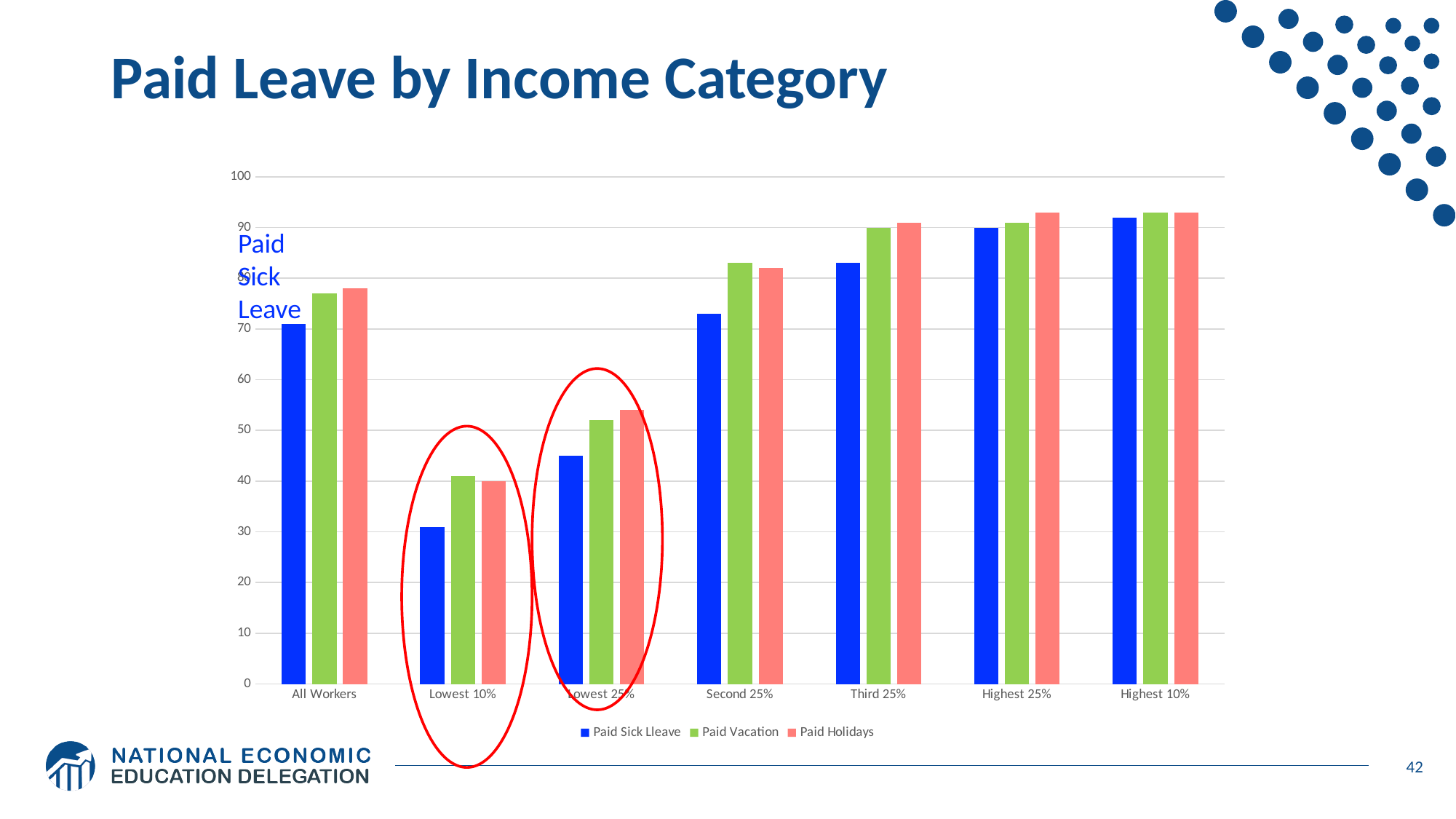
How many series does the legend list? 3 Which category has the highest Paid Sick Leave value? Highest 10% Is the Paid Sick Leave value for Second 25% greater or less than 70? greater Within the Lowest 10% category, which is larger: Paid Sick Leave or Paid Vacation? Paid Vacation How many income categories are shown on the x axis? 7 Is the Paid Sick Leave value for Lowest 10% greater or less than 40? less Moving from Lowest 10% to Highest 10% along the x axis, do the Paid Sick Leave values rise or fall? Rise Which category has the lowest Paid Sick Leave value? Lowest 10% What is the title of the chart on the slide? Paid Leave by Income Category Is the Paid Holidays value for Lowest 25% greater or less than 50? greater Which is larger: Paid Sick Leave for Lowest 10% or Paid Sick Leave for Lowest 25%? Lowest 25% What kind of chart is shown on the slide? Bar chart